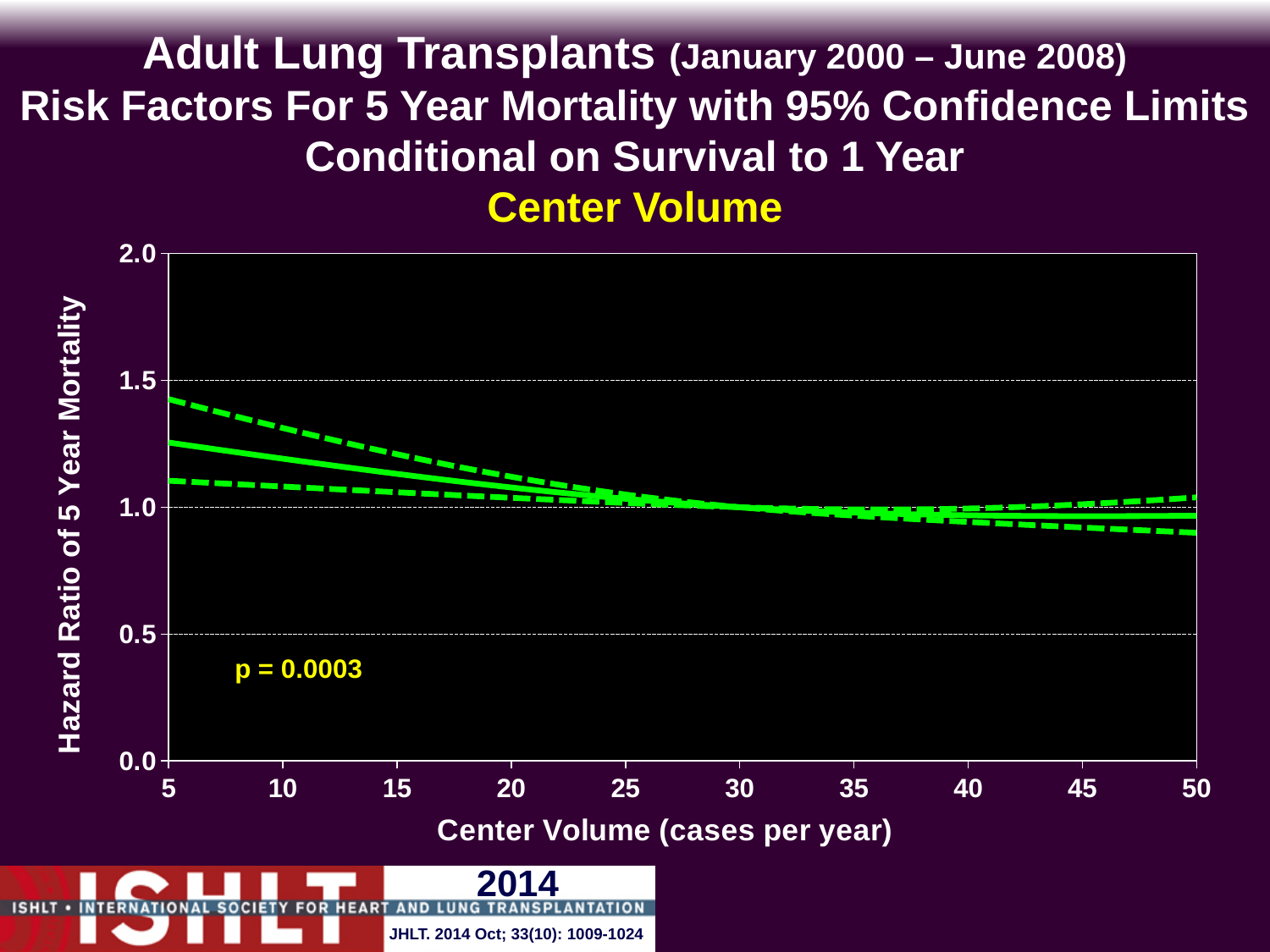
Is the lower 95% confidence limit at a center volume of 50 cases per year greater or less than 1.0? less Is the lower 95% confidence limit at a center volume of 5 cases per year greater or less than 1.0? greater What p-value is printed on the chart? p = 0.0003 Is the upper 95% confidence limit at a center volume of 5 cases per year greater or less than 1.5? less Does the hazard ratio of 5 year mortality rise or fall as center volume increases from 5 to 30 cases per year? fall What kind of chart is shown on the slide? line chart How many lines are plotted on the chart? 3 What is the label of the x axis? Center Volume (cases per year)